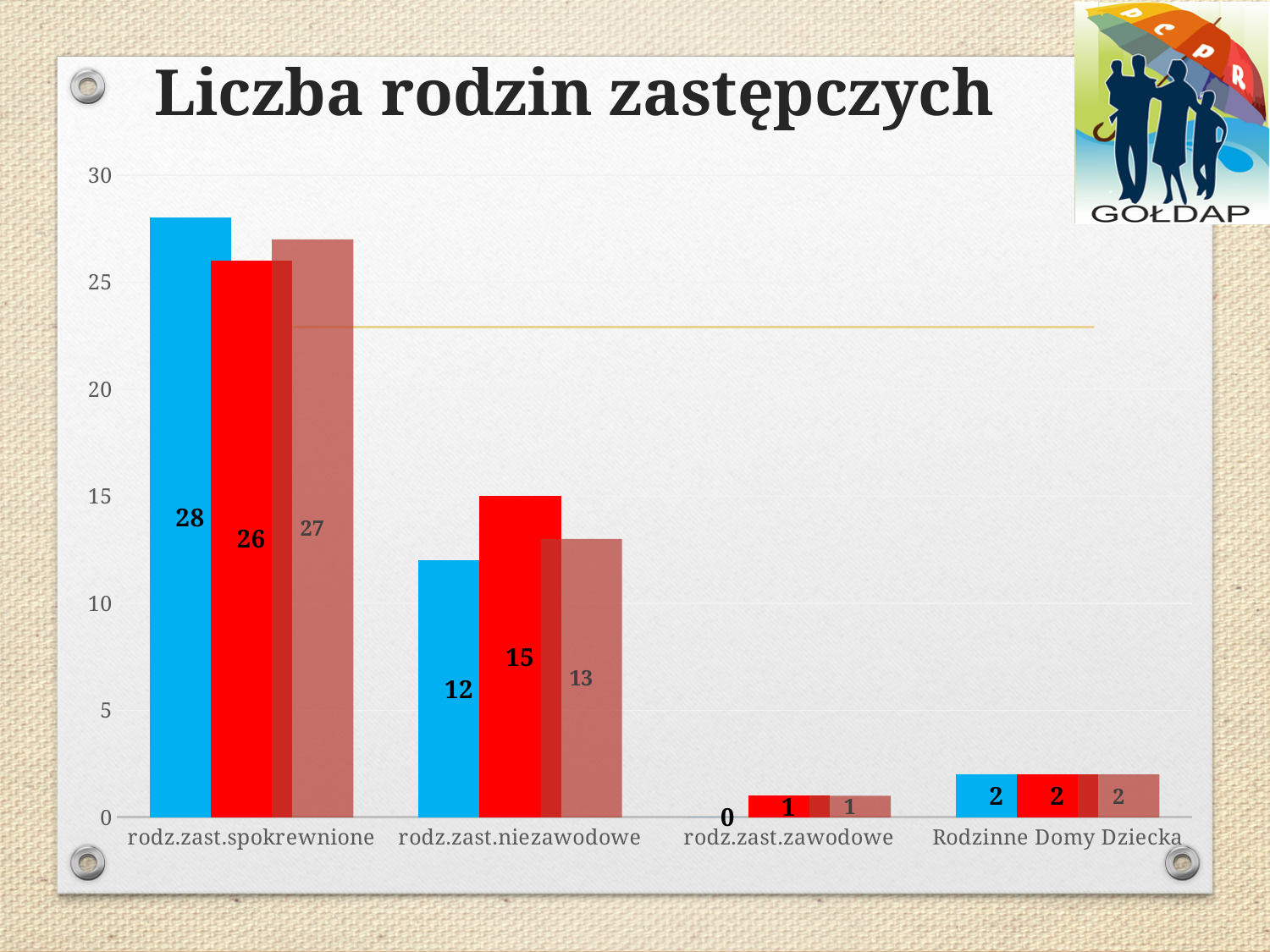
Which category has the highest blue bar? rodz.zast.spokrewnione What is the value of the blue bar for rodz.zast.zawodowe? 0 Which category has the lowest blue bar? rodz.zast.zawodowe What is the difference between the blue bar for rodz.zast.spokrewnione and the blue bar for rodz.zast.niezawodowe? 16 How many categories are shown on the x axis? 4 What is the value of the red bar for rodz.zast.niezawodowe? 15 What is the value of the blue bar for rodz.zast.spokrewnione? 28 What is the difference between the blue bar and the red bar for rodz.zast.niezawodowe? 3 What is the value of the brownish-red (third) bar for rodz.zast.spokrewnione? 27 For rodz.zast.spokrewnione, which is larger: the blue bar or the red bar? the blue bar What type of chart is shown on the slide? bar chart How many bars are plotted for each category? 3